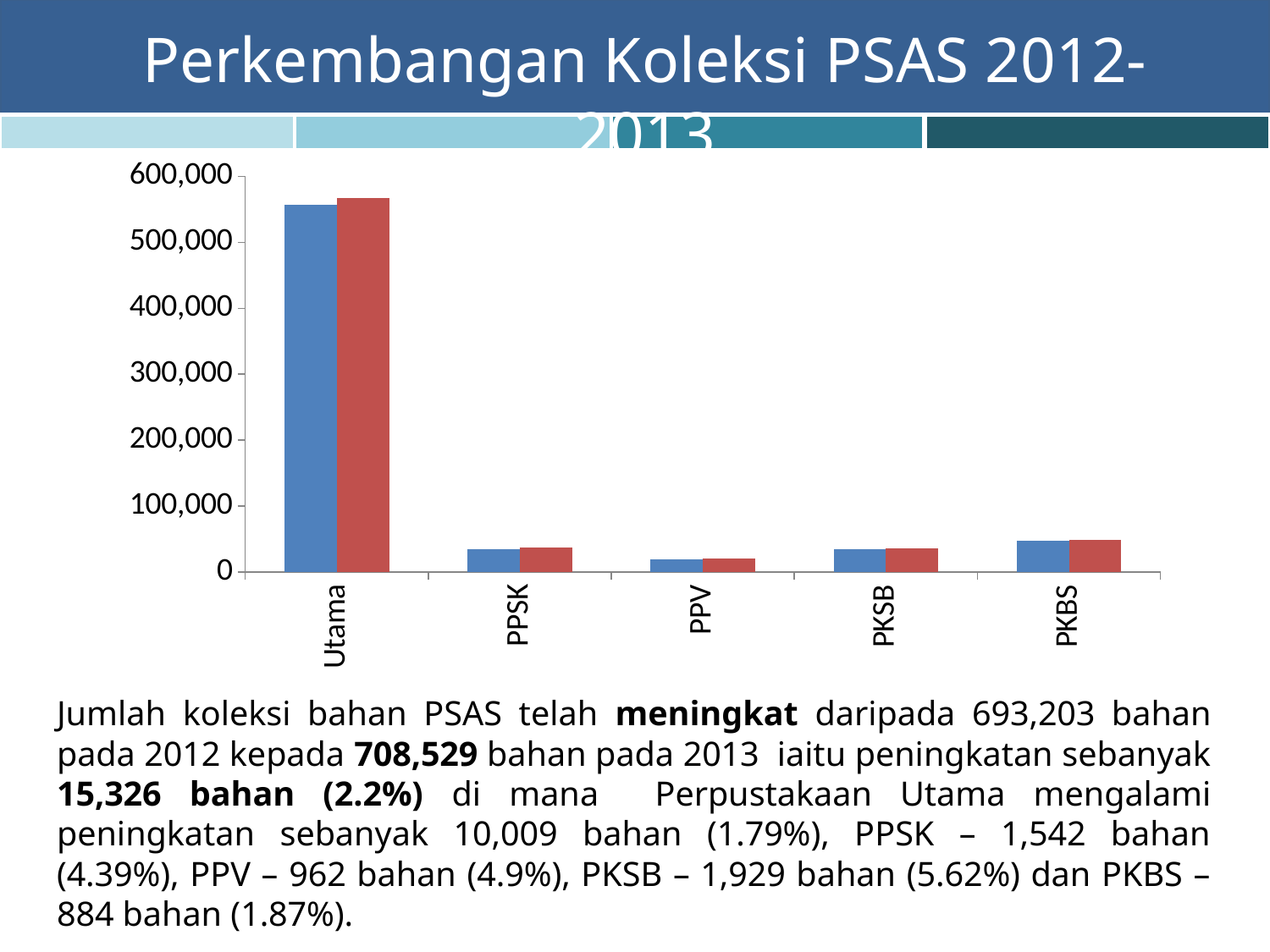
Which category has the lowest bars in the chart? PPV What is the highest value shown on the y axis of the chart? 600,000 Which category has larger bars, Utama or PKBS? Utama What kind of chart is shown on the slide? Bar chart Is the value of the blue bar for PPSK greater or less than 100,000? less Is the value of the red bar for PKBS greater or less than 100,000? less Is the value of the red bar for Utama greater or less than 600,000? less Which category has the highest bars in the chart? Utama What is the title of the slide containing the chart? Perkembangan Koleksi PSAS 2012-2013 Which category has larger bars, PKBS or PPV? PKBS How many categories are shown on the x axis of the chart? 5